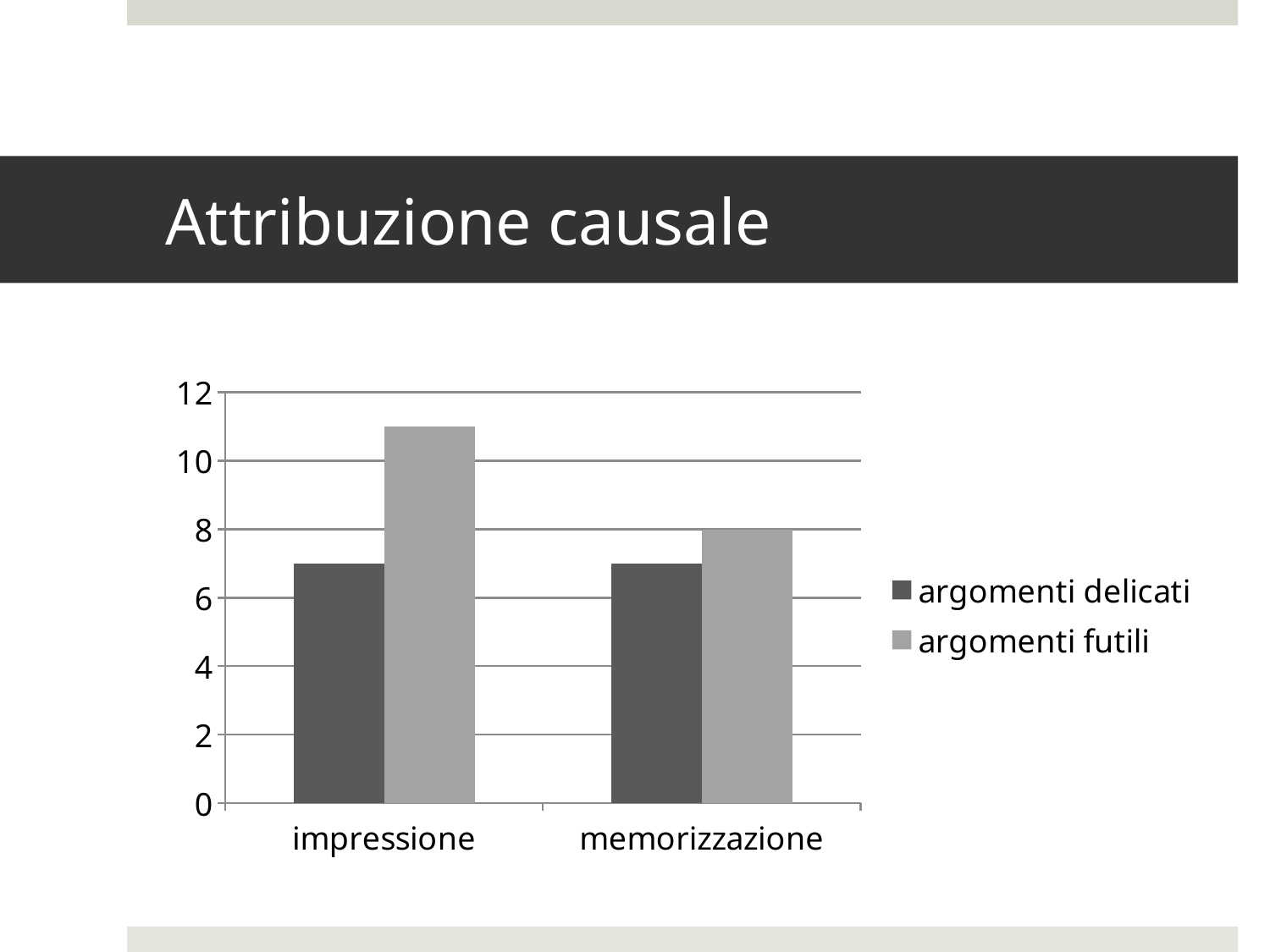
Is the value for argomenti delicati in the memorizzazione category greater or less than 6? greater Which category has the highest bar for argomenti futili? impressione What kind of chart is shown on the slide? bar chart In the impressione category, which series has the larger value, argomenti delicati or argomenti futili? argomenti futili Is the value for argomenti futili in the impressione category greater or less than 10? greater How many series does the chart's legend list? 2 What is the value for argomenti futili in the memorizzazione category? 8 Which series has the tallest bar in the whole chart? argomenti futili Does the value for argomenti futili rise or fall from impressione to memorizzazione? fall How many categories are shown on the x axis of the chart? 2 Is the value for argomenti delicati in the impressione category greater or less than 8? less What is the title of the slide containing the chart? Attribuzione causale